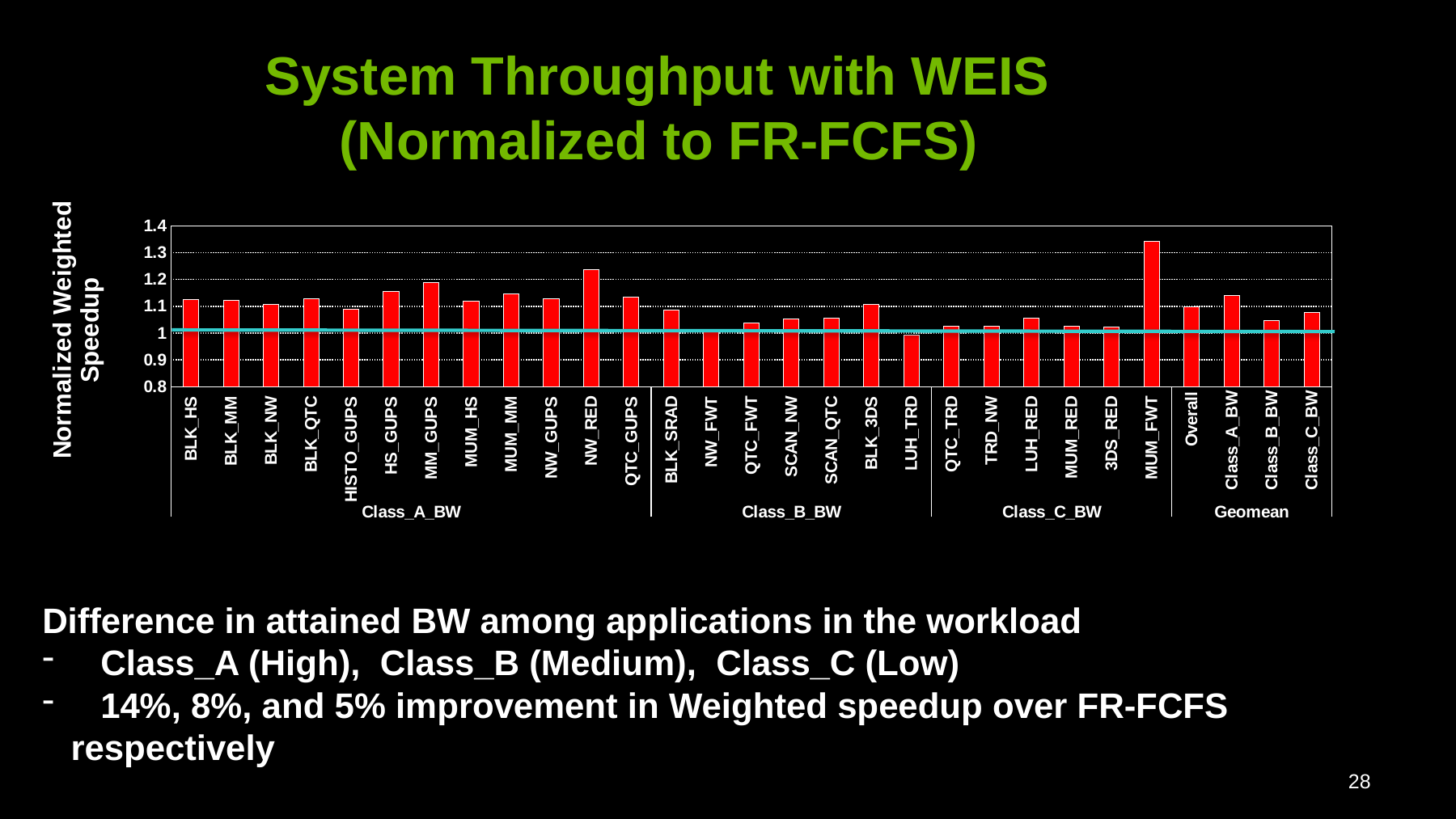
Which is larger, the value for NW_RED or the value for BLK_HS? NW_RED Is the value for NW_RED greater or less than 1.2? greater Which Geomean bar is larger, Class_A_BW or Class_C_BW? Class_A_BW Is the Geomean value for Class_C_BW greater or less than 1.1? less Which is larger, the value for HS_GUPS or the value for BLK_NW? HS_GUPS Is the value for BLK_HS greater or less than 1.1? greater How many bars are plotted in the chart? 29 What is the label of the y axis? Normalized Weighted Speedup What kind of chart is shown on the slide? bar chart Which category has the highest normalized weighted speedup? MUM_FWT